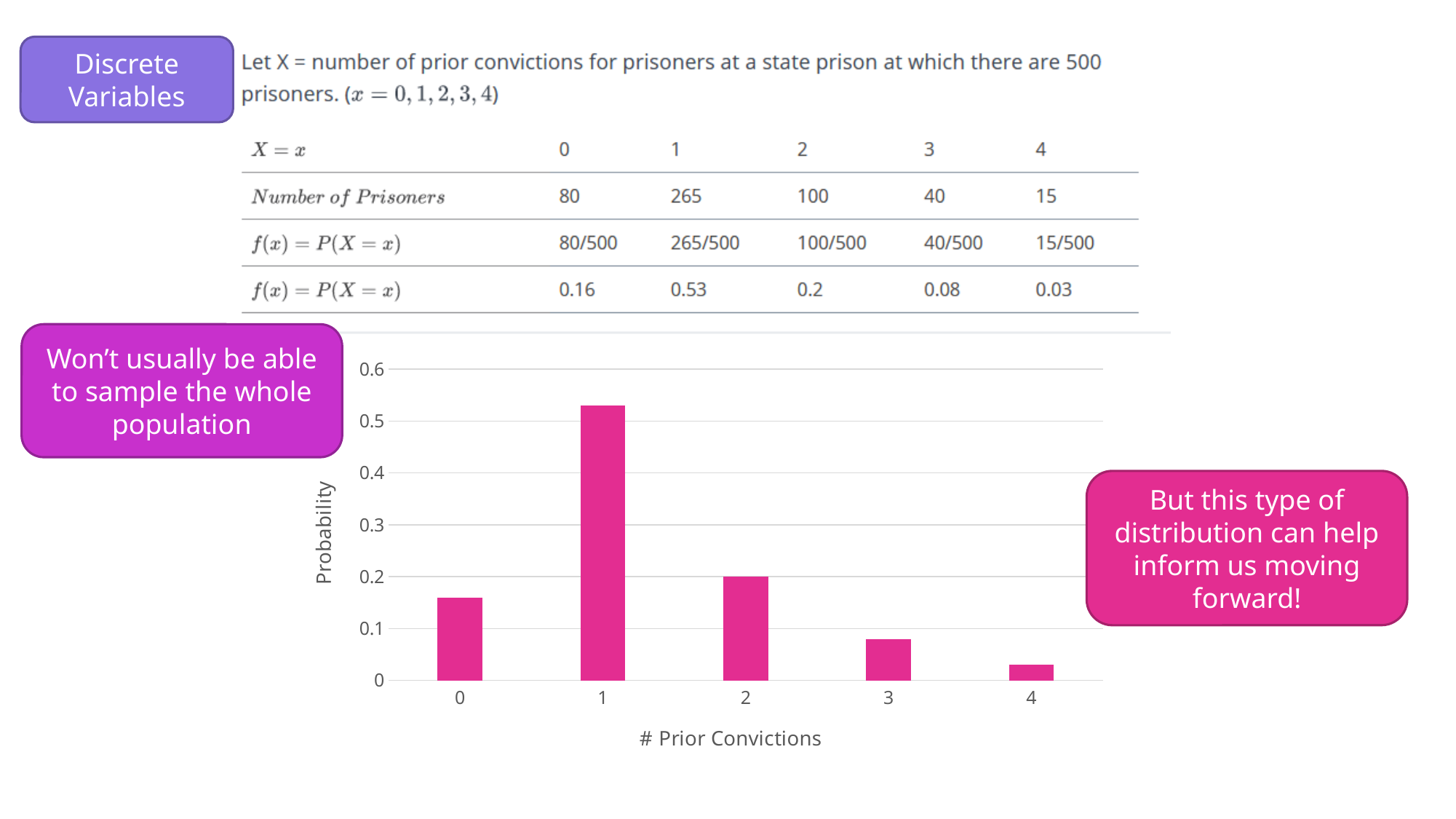
What is the difference between the probability for 1 prior conviction and the probability for 2 prior convictions? 0.33 How many bars does the chart have? 5 Is the probability for 1 prior conviction greater or less than 0.5? greater What is the probability plotted for 1 prior conviction? 0.53 Which has a higher probability, 0 prior convictions or 2 prior convictions? 2 prior convictions Which number of prior convictions has the highest probability in the chart? 1 What kind of chart is shown on the slide? bar chart Which number of prior convictions has the lowest probability in the chart? 4 What is the label of the x axis of the chart? # Prior Convictions Is the probability for 3 prior convictions greater or less than 0.1? less What is the probability plotted for 2 prior convictions? 0.2 What is the probability plotted for 0 prior convictions? 0.16